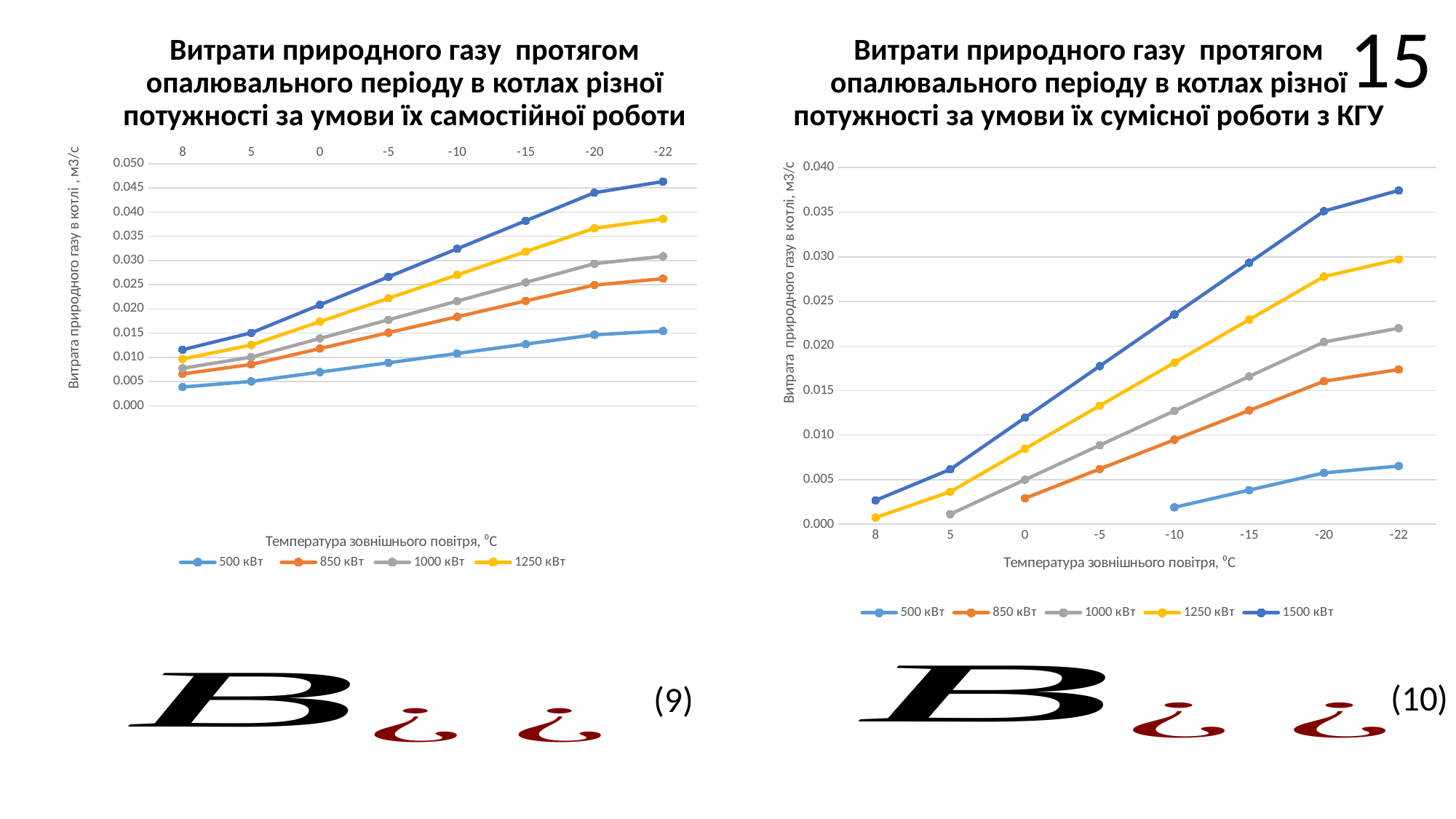
In the right chart (сумісної роботи з КГУ), how many data points does the 500 кВт series have? 4 How many series does the legend of the right chart (сумісної роботи з КГУ) list? 5 In the right chart (сумісної роботи з КГУ), which is larger at -22 °C: the 1250 кВт series or the 1000 кВт series? 1250 кВт How many temperature categories are shown on the x axis of the right chart (сумісної роботи з КГУ)? 8 How many series does the legend of the left chart (самостійної роботи) list? 4 In the right chart (сумісної роботи з КГУ), which series has the lowest value at -22 °C? 500 кВт In the left chart (самостійної роботи), do the values of the 1250 кВт series rise or fall moving from 8 °C to -22 °C along the x axis? rise In the left chart (самостійної роботи), is the value for 500 кВт at -22 °C greater or less than 0.010? greater What kind of chart is the left chart, 'Витрати природного газу протягом опалювального періоду в котлах різної потужності за умови їх самостійної роботи'? line chart In the right chart (сумісної роботи з КГУ), is the value for 1500 кВт at -22 °C greater or less than 0.035? greater In the right chart (сумісної роботи з КГУ), which series has the highest value at -22 °C? 1500 кВт In the right chart (сумісної роботи з КГУ), is the value for 850 кВт at 0 °C greater or less than 0.005? less